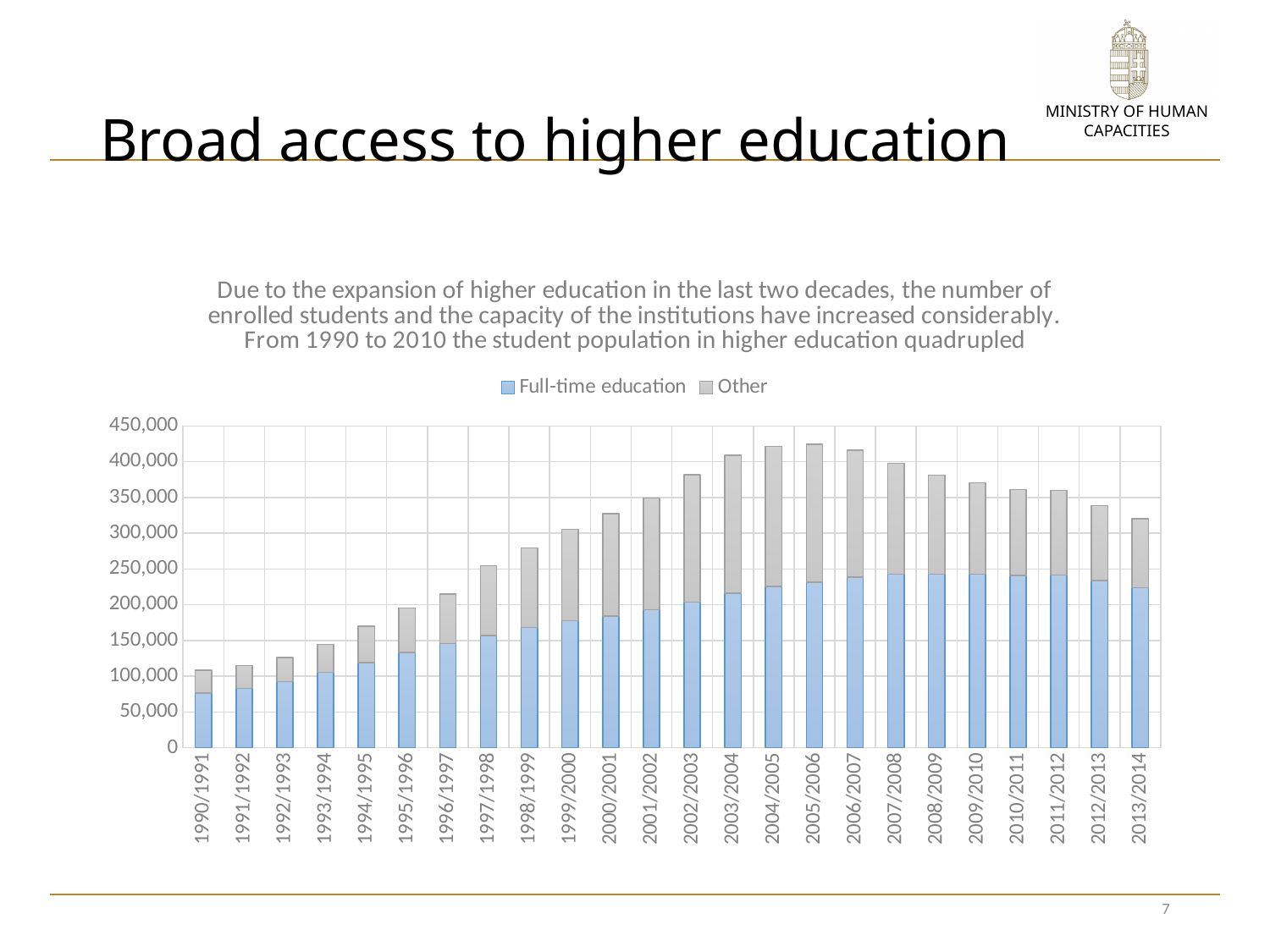
Is the total value for 2005/2006 greater or less than 400,000? greater Is the total value for 1990/1991 greater or less than 150,000? less Do the total values rise or fall from 1990/1991 to 2005/2006? rise What kind of chart is shown on the slide? stacked bar chart Which has a larger total value, 2013/2014 or 1990/1991? 2013/2014 Is the Full-time education value for 2013/2014 greater or less than 200,000? greater Which colour represents the Full-time education series in the chart? blue What are the two series named in the chart legend? Full-time education and Other Which academic year has the lowest total number of students in the chart? 1990/1991 How many academic years are shown on the x axis of the chart? 24 How many series does the chart legend list? 2